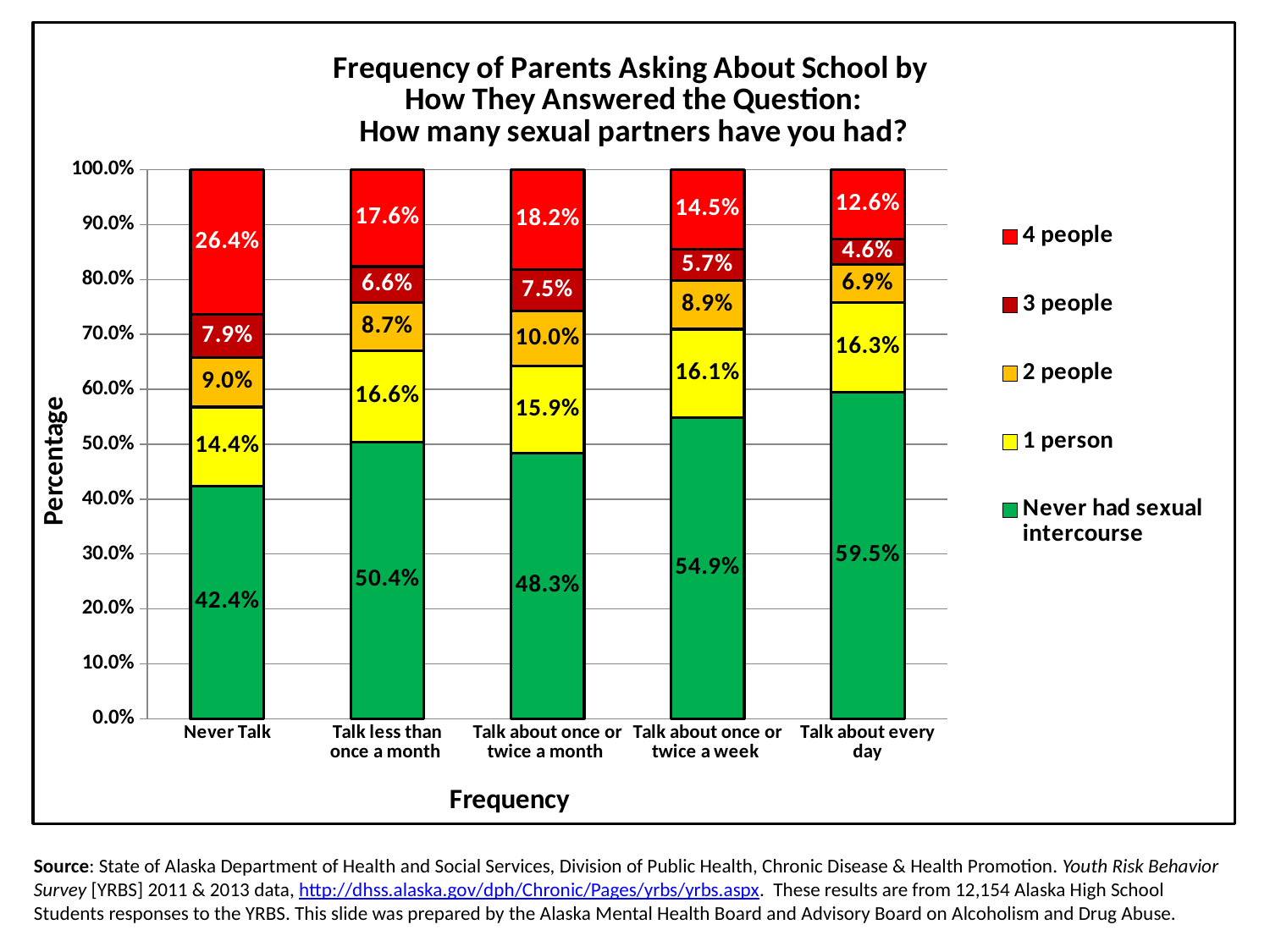
What is the value for "3 people" in the "Talk about once or twice a week" bar? 5.7% Which has the larger "2 people" value: "Never Talk" or "Talk about once or twice a month"? Talk about once or twice a month Which frequency category has the highest percentage for "Never had sexual intercourse"? Talk about every day What percentage of students who answered "Never Talk" had never had sexual intercourse? 42.4% What is the value for "4 people" in the "Talk about every day" bar? 12.6% How many series does the legend list? 5 What colour represents "Never had sexual intercourse" in the legend? Green What kind of chart is shown on the slide? Stacked bar chart Does the "4 people" percentage generally rise or fall moving from "Never Talk" to "Talk about every day"? Fall Which frequency category has the lowest percentage for "4 people"? Talk about every day How many percentage points higher is the "4 people" value for "Never Talk" than for "Talk about every day"? 13.8 percentage points How many frequency categories are shown on the x axis? 5